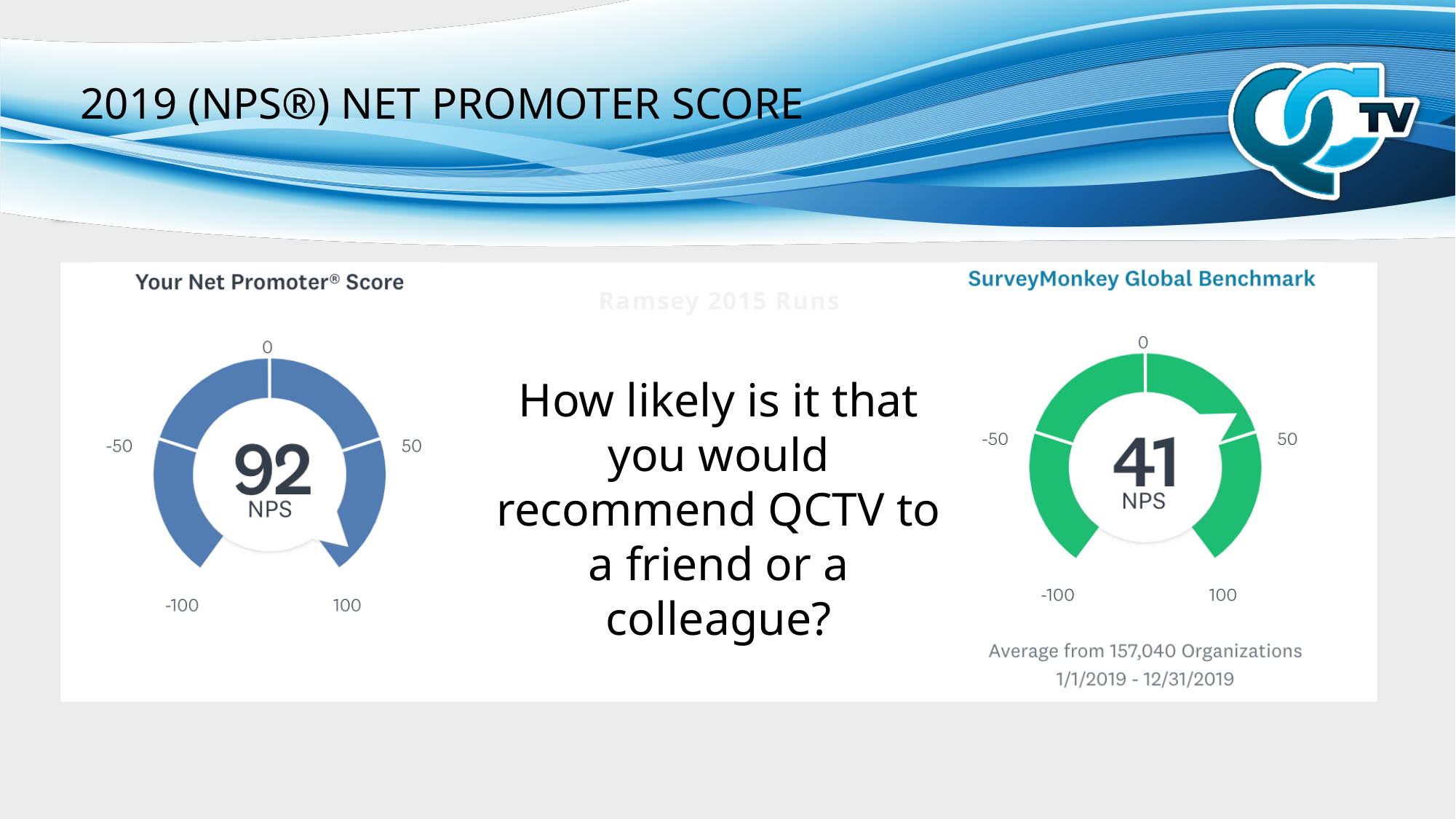
On the 'SurveyMonkey Global Benchmark' gauge, is the NPS value greater or less than 50? less What colour is the 'SurveyMonkey Global Benchmark' gauge? Green What kind of chart is used on the left side of the slide to show the Net Promoter Score? Gauge chart On the 'SurveyMonkey Global Benchmark' gauge, what NPS value is shown? 41 On the 'Your Net Promoter Score' gauge, is the NPS value greater or less than 50? greater Which gauge shows the higher NPS, 'Your Net Promoter Score' or 'SurveyMonkey Global Benchmark'? Your Net Promoter Score According to the text under the 'SurveyMonkey Global Benchmark' gauge, how many organizations is the average taken from? 157,040 On the 'Your Net Promoter Score' gauge, what NPS value is shown? 92 On the 'Your Net Promoter Score' gauge, what is the lowest value marked on the scale? -100 What is the difference between the NPS on the 'Your Net Promoter Score' gauge and the NPS on the 'SurveyMonkey Global Benchmark' gauge? 51 On the 'SurveyMonkey Global Benchmark' gauge, what is the highest value marked on the scale? 100 How many gauge charts are shown on the slide? 2